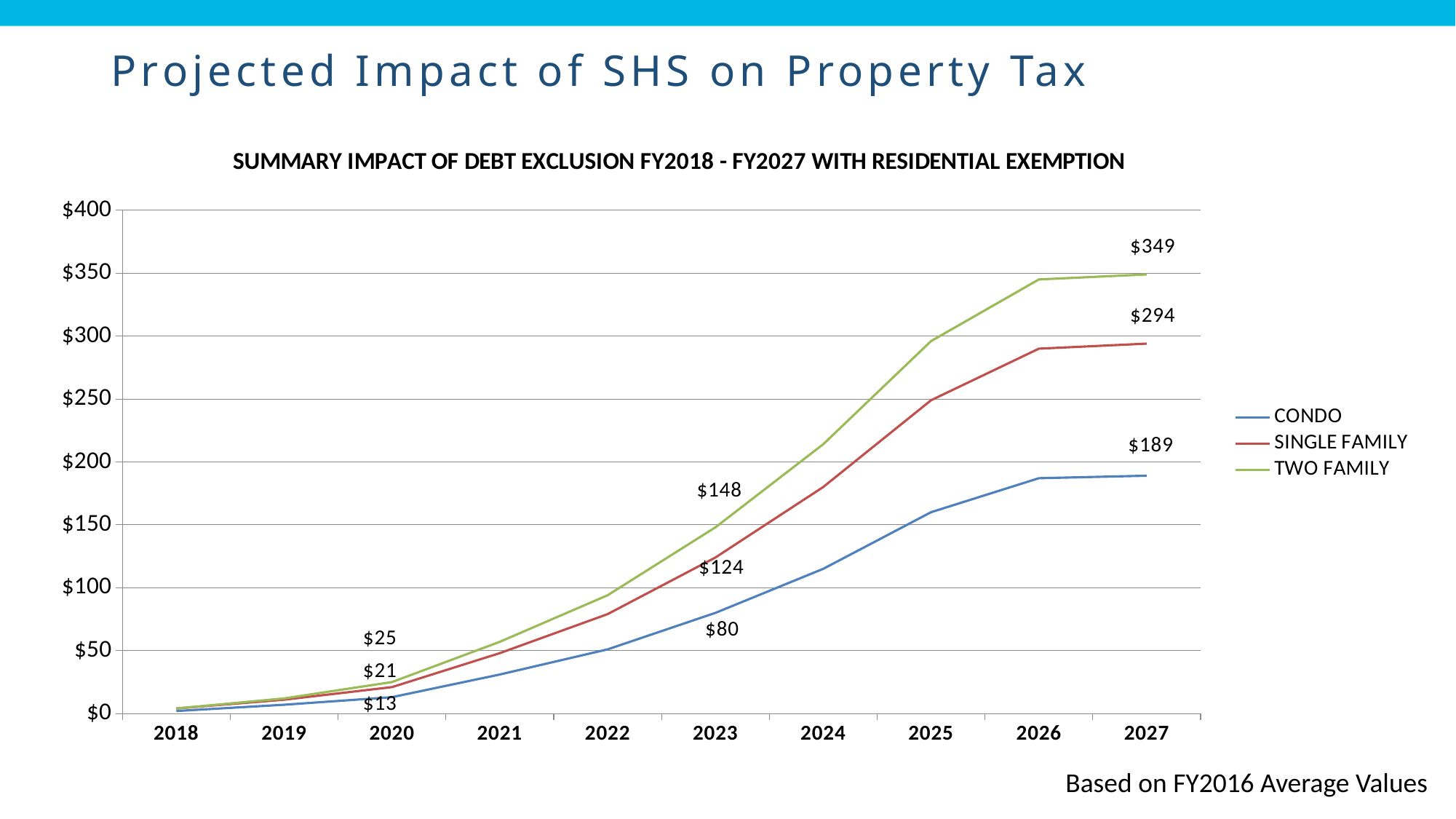
How many series does the legend list? 3 Which series has the highest value in 2027? TWO FAMILY What is the difference between the TWO FAMILY and CONDO values in 2027? $160 Is the value for SINGLE FAMILY in 2025 greater or less than $200? greater How many years are shown on the x axis? 10 What kind of chart is shown on the slide? Line chart What is the value for CONDO in 2020? $13 Which series has the lowest value in 2023? CONDO What is the value for TWO FAMILY in 2027? $349 What is the value for SINGLE FAMILY in 2023? $124 What is the difference between the SINGLE FAMILY and CONDO values in 2020? $8 Which is larger in 2023, the TWO FAMILY value or the SINGLE FAMILY value? TWO FAMILY